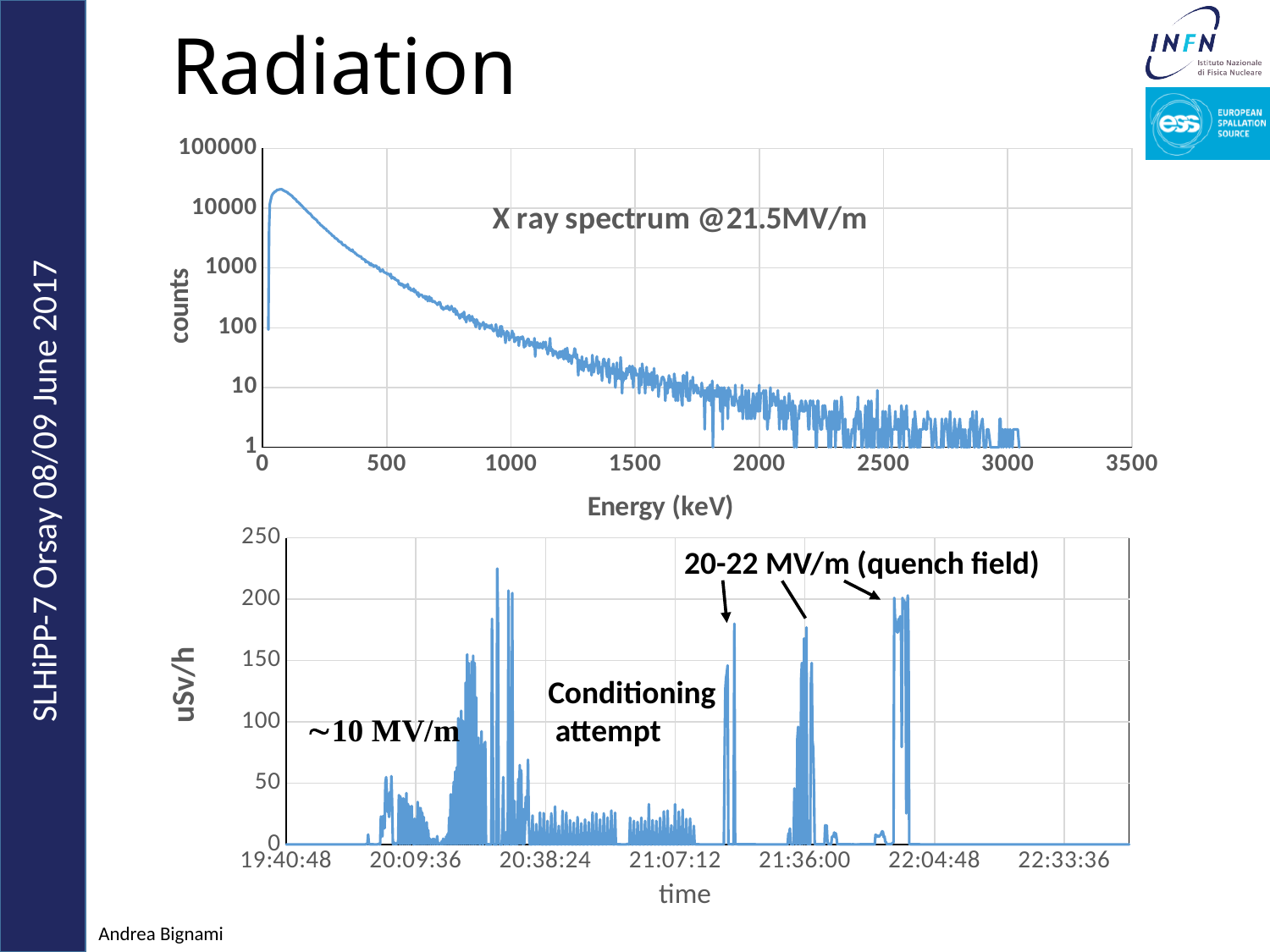
In the bottom chart, what is the label of the x axis? time In the top chart 'X ray spectrum @21.5MV/m', what is the highest tick value shown on the x axis? 3500 In the bottom chart, is the highest peak of the uSv/h trace greater or less than 200? greater In the top chart 'X ray spectrum @21.5MV/m', what is the label of the y axis? counts What kind of chart is the bottom chart with the y axis labelled 'uSv/h'? line chart In the top chart 'X ray spectrum @21.5MV/m', what is the label of the x axis? Energy (keV) In the bottom chart, is the peak of the uSv/h trace near 20:09:36 greater or less than 100? less In the top chart 'X ray spectrum @21.5MV/m', is the peak value of counts greater or less than 10000? greater In the bottom chart, what is the highest tick value shown on the y axis? 250 What kind of chart is the top chart titled 'X ray spectrum @21.5MV/m'? line chart In the top chart 'X ray spectrum @21.5MV/m', do the counts generally rise or fall as energy increases beyond the initial peak? fall